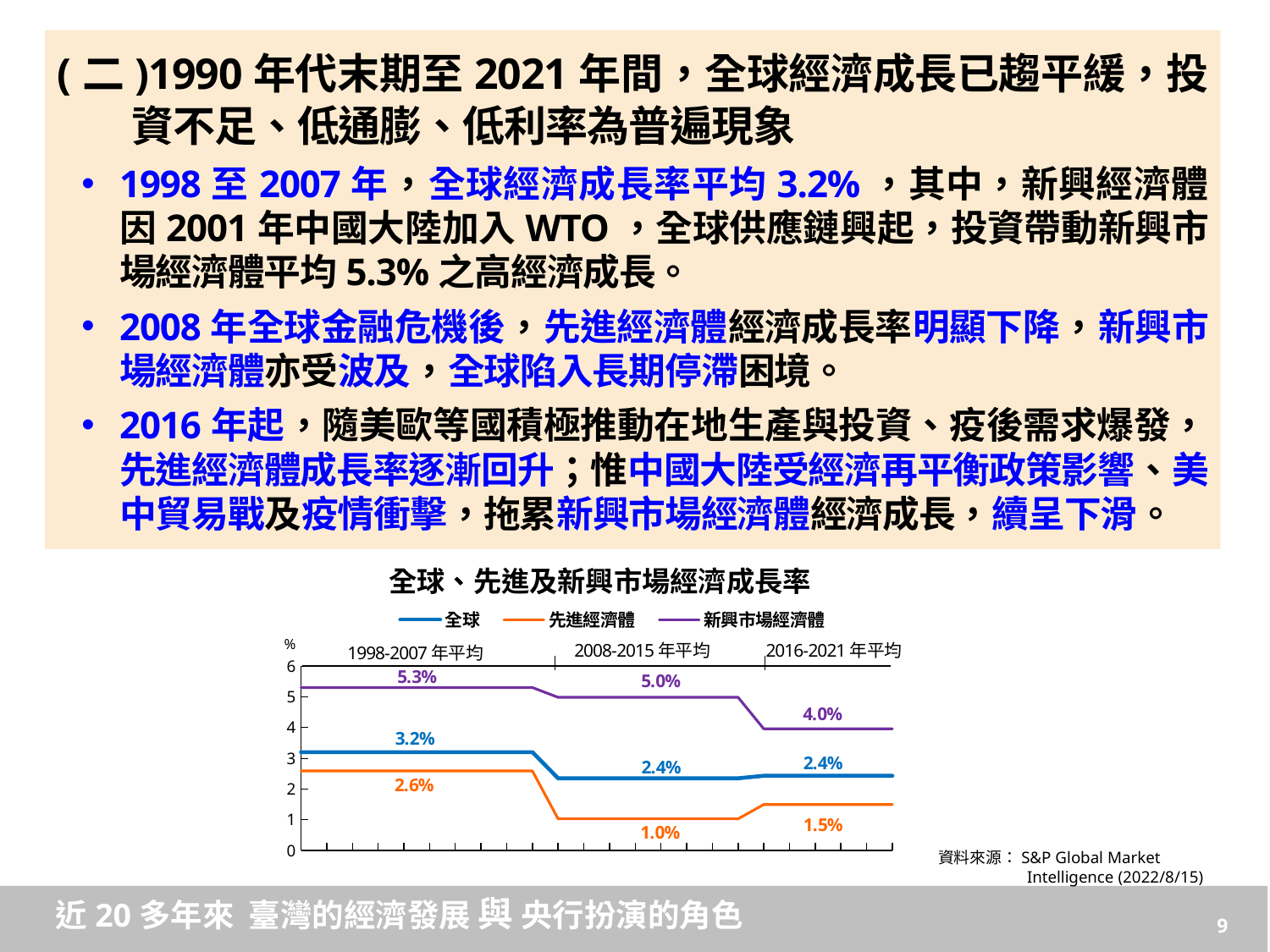
What is the average growth rate for 全球 in the 2008-2015 年平均 period? 2.4% How do the 新興市場經濟體 values change across the three periods from left to right? fall What is the average growth rate for 新興市場經濟體 in the 1998-2007 年平均 period? 5.3% Which series has the highest value in the 2016-2021 年平均 period? 新興市場經濟體 Which series has the lowest value in the 1998-2007 年平均 period? 先進經濟體 What type of chart is shown on the slide? line chart How many series does the legend of the chart list? 3 What is the difference between the 新興市場經濟體 and 全球 values in the 1998-2007 年平均 period? 2.1% What is the average growth rate for 先進經濟體 in the 2016-2021 年平均 period? 1.5% What is the title of the chart? 全球、先進及新興市場經濟成長率 What is the average growth rate for 先進經濟體 in the 2008-2015 年平均 period? 1.0% Which is larger: the 先進經濟體 value in 1998-2007 年平均 or in 2016-2021 年平均? 1998-2007 年平均